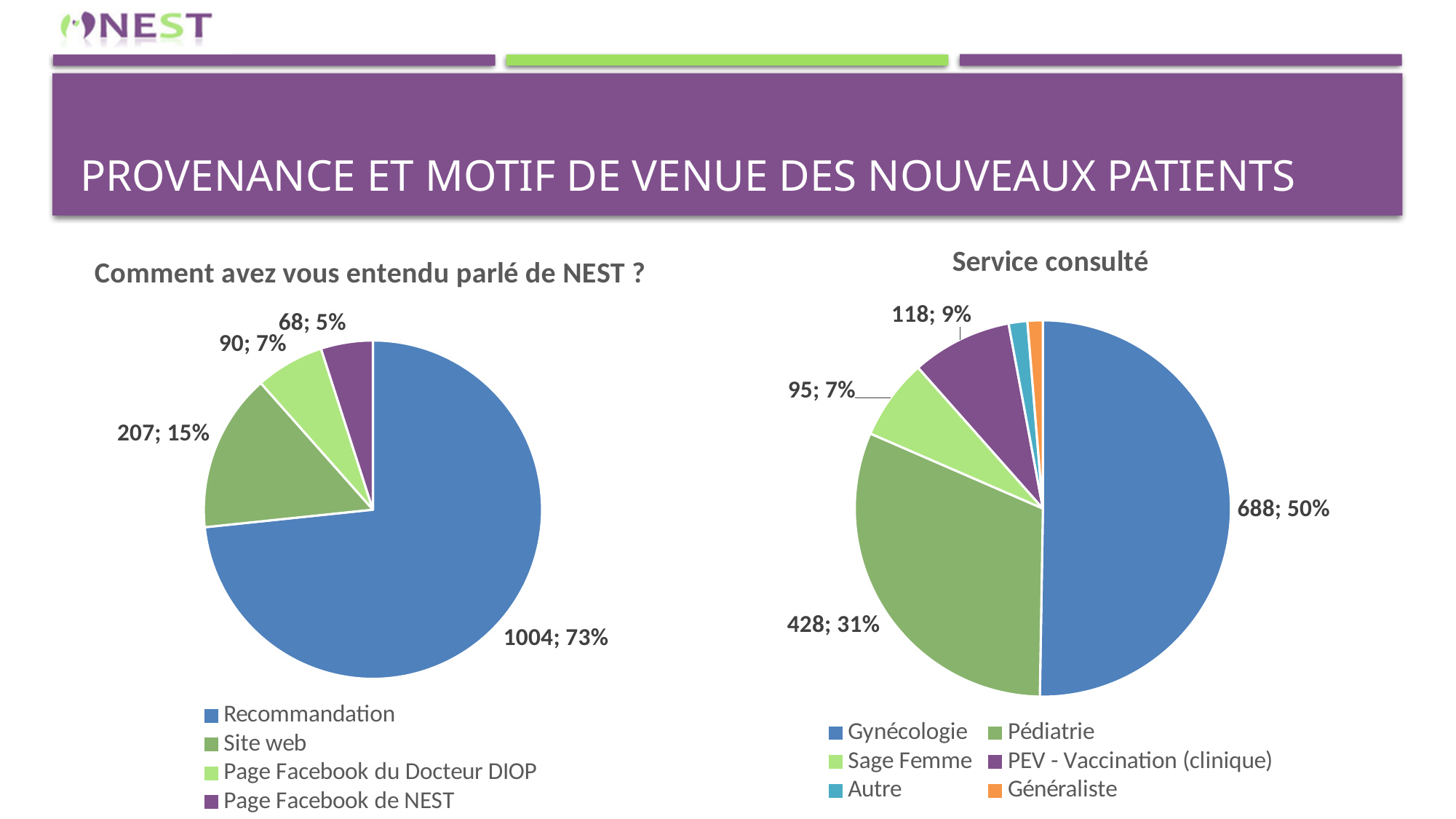
In the chart titled "Comment avez vous entendu parlé de NEST ?", what value is shown for Recommandation? 1004; 73% In the "Service consulté" chart, which service has the largest slice? Gynécologie In the "Service consulté" chart, what is the difference between the counts for Gynécologie and Pédiatrie? 260 In the chart titled "Comment avez vous entendu parlé de NEST ?", how many categories does the legend list? 4 In the chart titled "Comment avez vous entendu parlé de NEST ?", what is the difference between the counts for Site web and Page Facebook du Docteur DIOP? 117 In the "Service consulté" chart, how many categories does the legend list? 6 In the chart titled "Comment avez vous entendu parlé de NEST ?", which category has the smallest slice? Page Facebook de NEST In the chart titled "Comment avez vous entendu parlé de NEST ?", what share of the pie does Site web represent? 15% In the "Service consulté" chart, what colour is the Généraliste slice? Orange In the "Service consulté" chart, which is larger, PEV - Vaccination (clinique) or Sage Femme? PEV - Vaccination (clinique) In the "Service consulté" chart, what value is shown for Pédiatrie? 428; 31% What kind of chart is the "Service consulté" chart? Pie chart